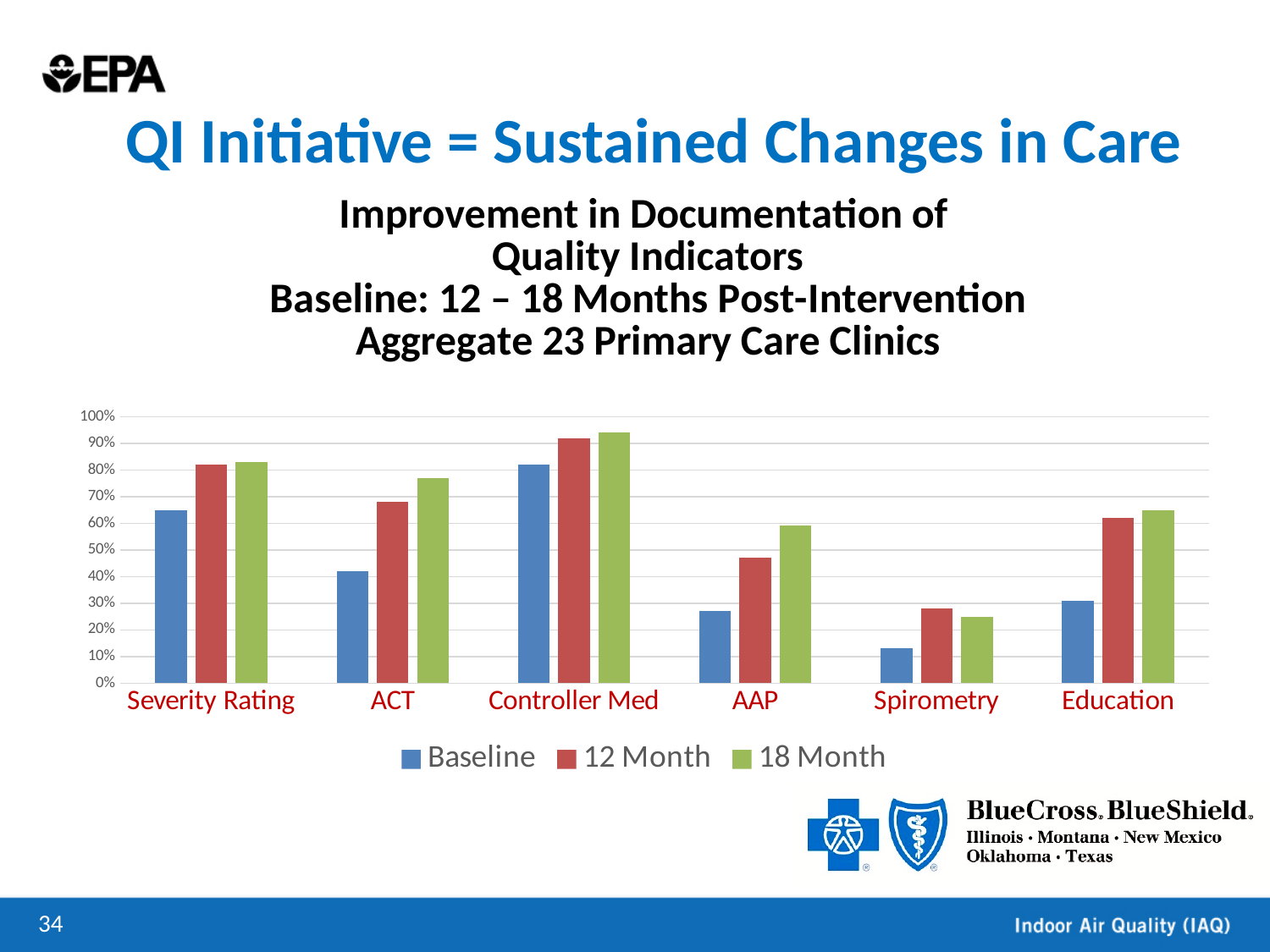
Is the Baseline value for ACT greater or less than 50%? less Which category has the lowest Baseline value? Spirometry Is the 18 Month value for Controller Med greater or less than 90%? greater Which category has the highest 18 Month value? Controller Med How many series does the legend list? 3 How many categories are shown on the x axis? 6 For Education, which is larger: the Baseline value or the 12 Month value? 12 Month Is the Baseline value for Spirometry greater or less than 20%? less What are the three series named in the legend? Baseline, 12 Month, 18 Month What kind of chart is shown on the slide? Bar chart For AAP, which is larger: the 12 Month value or the 18 Month value? 18 Month Which category has the highest Baseline value? Controller Med